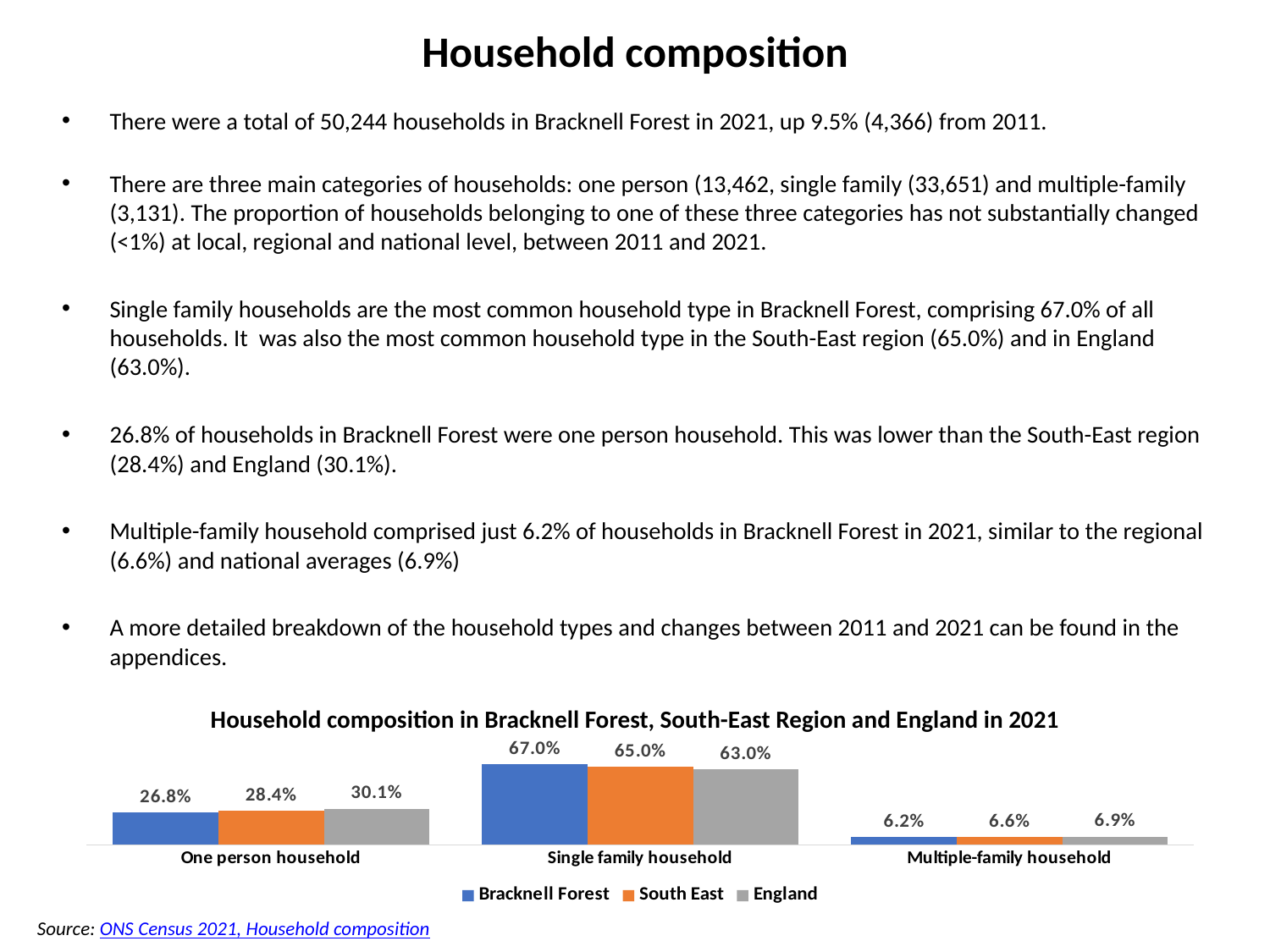
Which household category has the highest value for Bracknell Forest? Single family household What is the difference between the Bracknell Forest and England values for Single family household? 4.0% Which household category has the lowest value for England? Multiple-family household What is the value for South East in the Multiple-family household category? 6.6% What kind of chart is shown on the slide? Bar chart Which is larger for One person household: Bracknell Forest or South East? South East How many household categories are shown on the x axis? 3 What is the value for England in the Single family household category? 63.0% What is the value for Bracknell Forest in the One person household category? 26.8% What is the title of the chart? Household composition in Bracknell Forest, South-East Region and England in 2021 How many series does the legend list? 3 What is the difference between the England and Bracknell Forest values for One person household? 3.3%